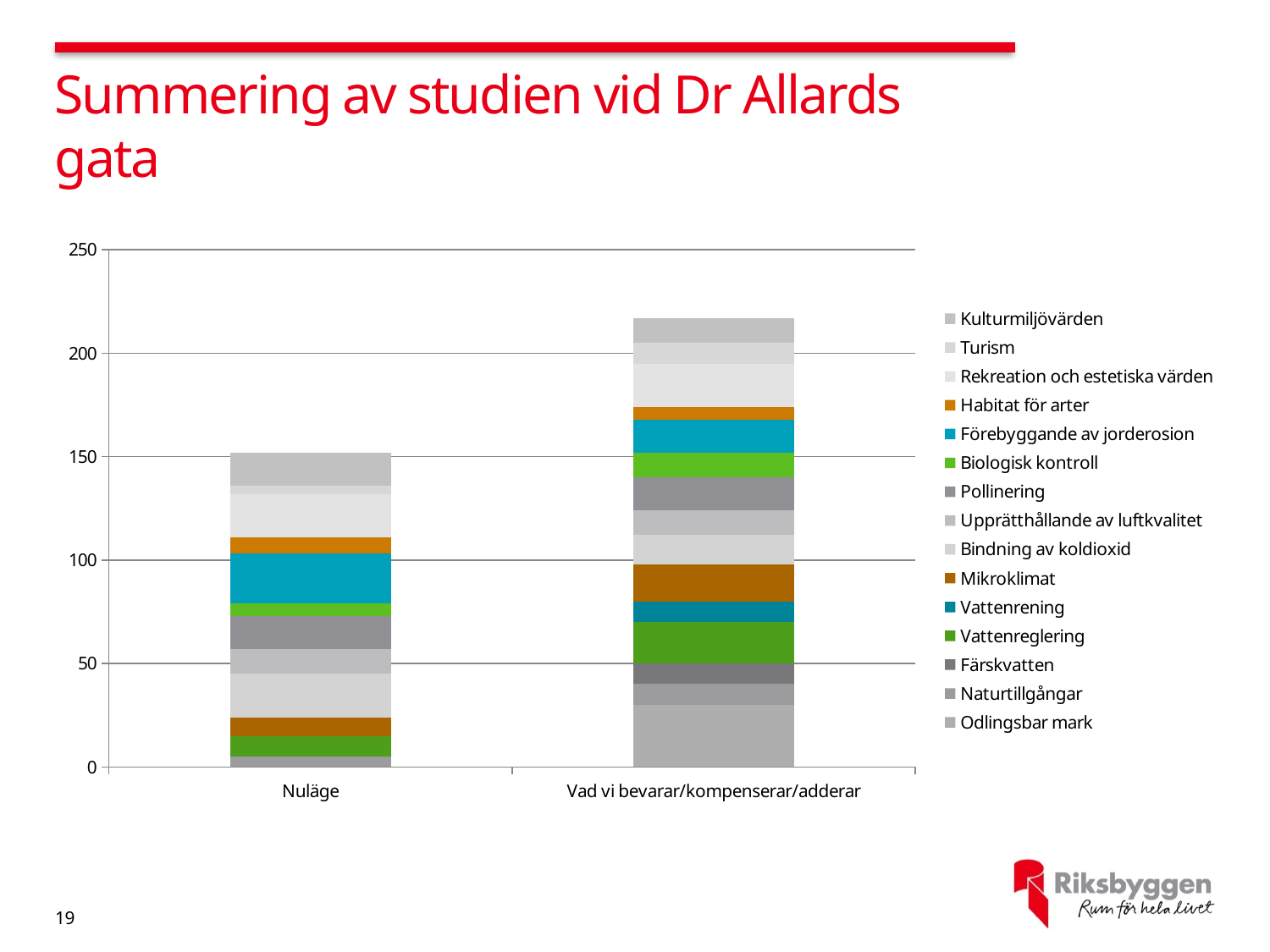
Is the total value of the bar for Vad vi bevarar/kompenserar/adderar greater or less than 200? greater Is the total value of the bar for Nuläge greater or less than 100? greater Is the total value of the bar for Nuläge greater or less than 200? less Do the total bar values rise or fall from Nuläge to Vad vi bevarar/kompenserar/adderar? rise How many series does the chart's legend list? 15 Which category has the lowest total bar in the chart? Nuläge Which category has the highest total bar in the chart? Vad vi bevarar/kompenserar/adderar What is the first entry listed in the chart's legend? Kulturmiljövärden Which category has the taller stacked bar, Nuläge or Vad vi bevarar/kompenserar/adderar? Vad vi bevarar/kompenserar/adderar How many categories are shown on the x axis of the chart? 2 What is the highest value shown on the chart's vertical axis? 250 What kind of chart is shown on the slide? Stacked bar chart